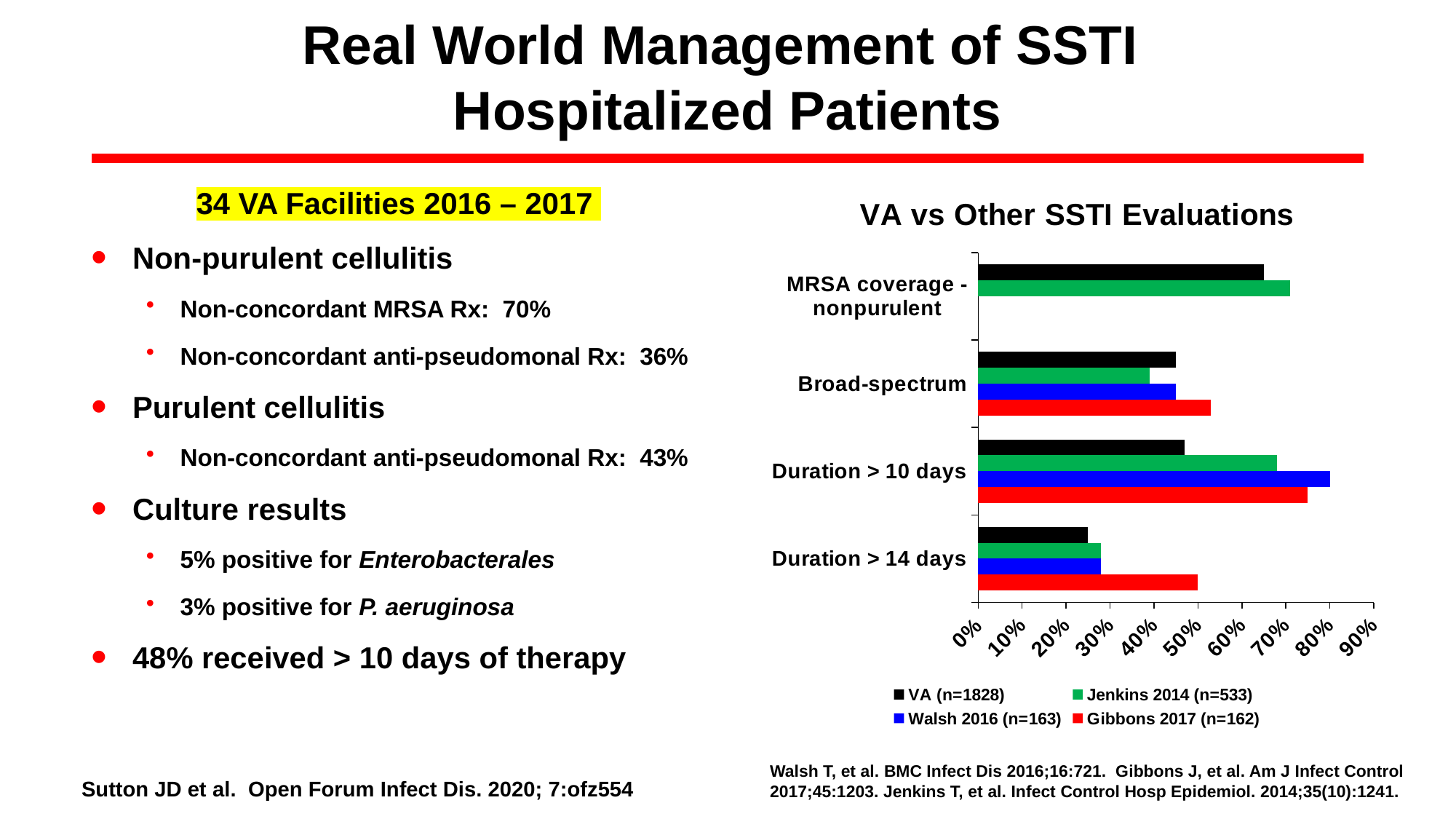
Is the VA (n=1828) value for Duration > 14 days greater or less than 30%? less Which series has the highest value for Broad-spectrum? Gibbons 2017 (n=162) What type of chart is shown on the slide? bar chart Is the Walsh 2016 (n=163) value for Duration > 10 days greater or less than 70%? greater How many series does the chart legend list? 4 Which category on the chart has bars for only two of the series? MRSA coverage - nonpurulent For Duration > 14 days, which is larger: the VA (n=1828) value or the Gibbons 2017 (n=162) value? Gibbons 2017 (n=162) Which series has the highest value for Duration > 10 days? Walsh 2016 (n=163) What is the title of the chart? VA vs Other SSTI Evaluations How many categories are shown on the chart's vertical axis? 4 Is the VA (n=1828) value for MRSA coverage - nonpurulent greater or less than 60%? greater Which series has the highest value for Duration > 14 days? Gibbons 2017 (n=162)